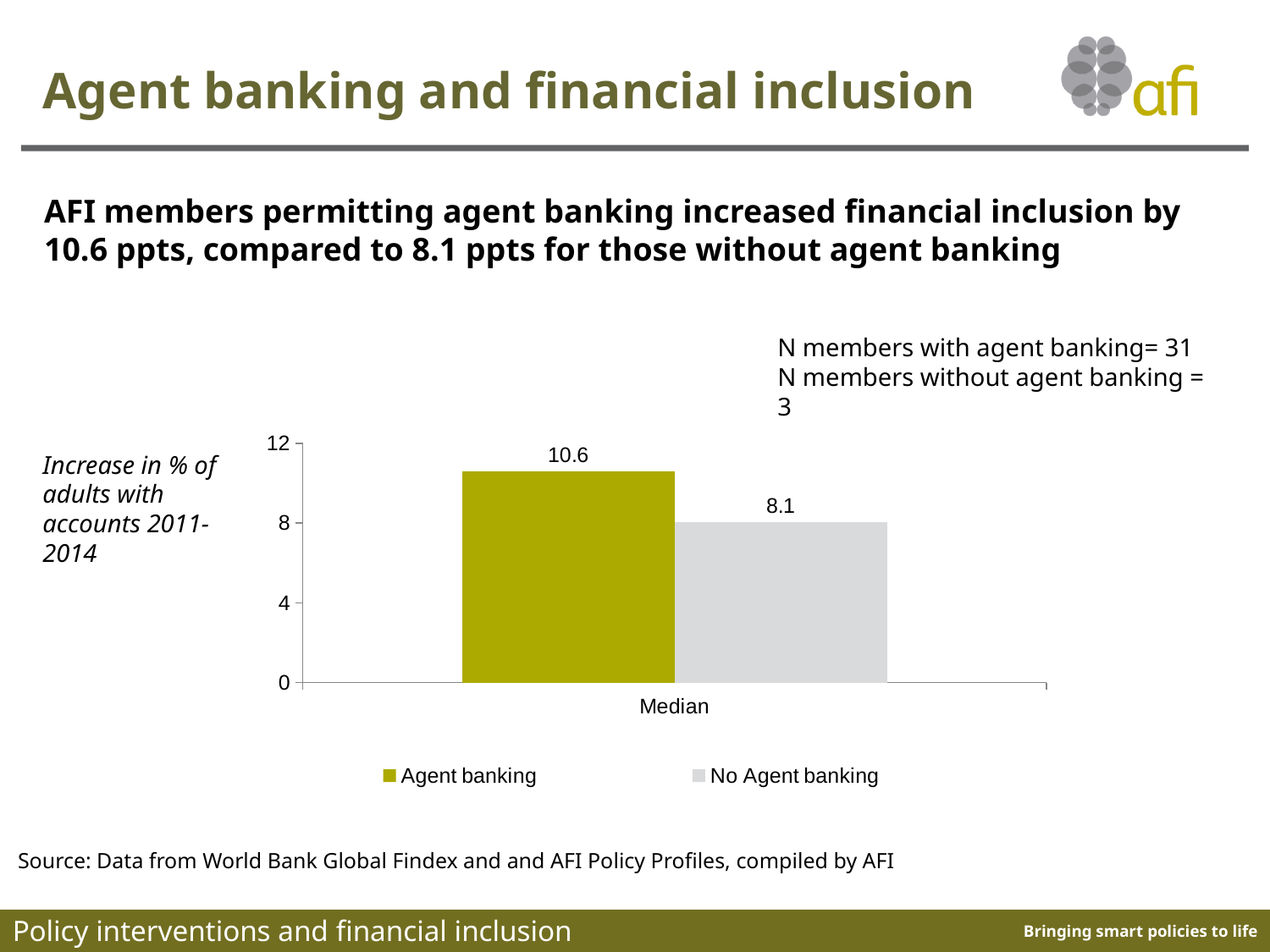
Which series has the higher value: Agent banking or No Agent banking? Agent banking How many series does the legend list? 2 Which series has the lowest value in the chart? No Agent banking What is the label of the category on the x axis? Median What is the value for Agent banking in the Median category? 10.6 Is the value for No Agent banking greater or less than 12? less What is the difference between the Agent banking value and the No Agent banking value? 2.5 What is the value for No Agent banking in the Median category? 8.1 Is the value for Agent banking greater or less than 8? greater What is the maximum value shown on the y axis? 12 How many categories are shown on the x axis? 1 What kind of chart is shown on the slide? Bar chart